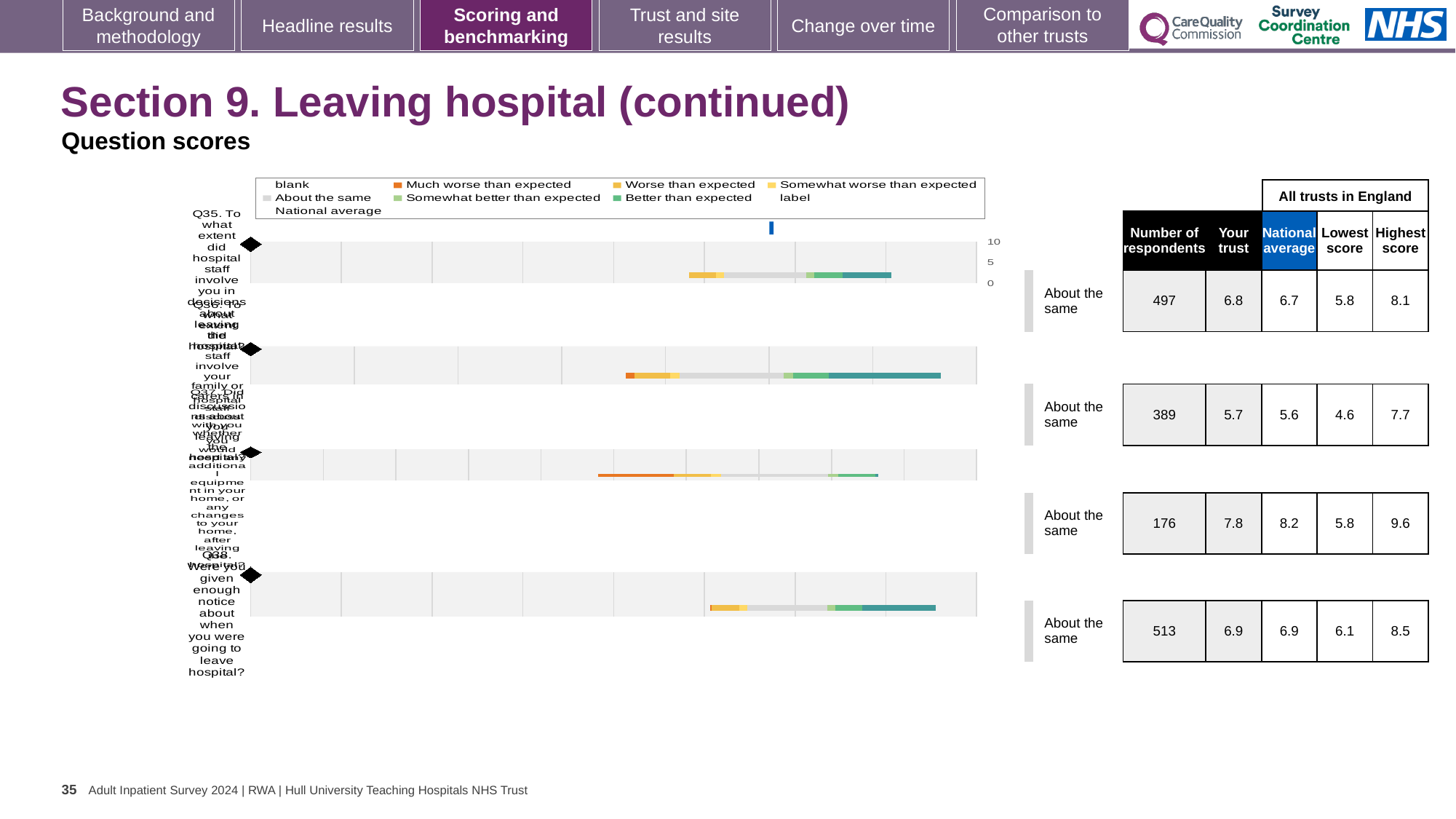
What is the 'Your trust' score for Q38 (Were you given enough notice about when you were going to leave hospital?)? 6.9 What is the lowest score among all trusts in England for Q38? 6.1 How many questions (bars) are plotted in the question scores chart? 4 What is the highest score among all trusts in England for Q36? 7.7 Which of the four questions has the highest 'Your trust' score? Q37 What is the national average score for Q35? 6.7 What benchmark category is shown for Q36? About the same Which of the four questions has the lowest 'Your trust' score? Q36 What is the difference between the 'Your trust' score and the national average for Q37? 0.4 Is the 'Your trust' score for Q35 larger or smaller than the national average for Q35? larger How many respondents answered Q37? 176 What kind of chart is used to show the question scores on this slide? bar chart